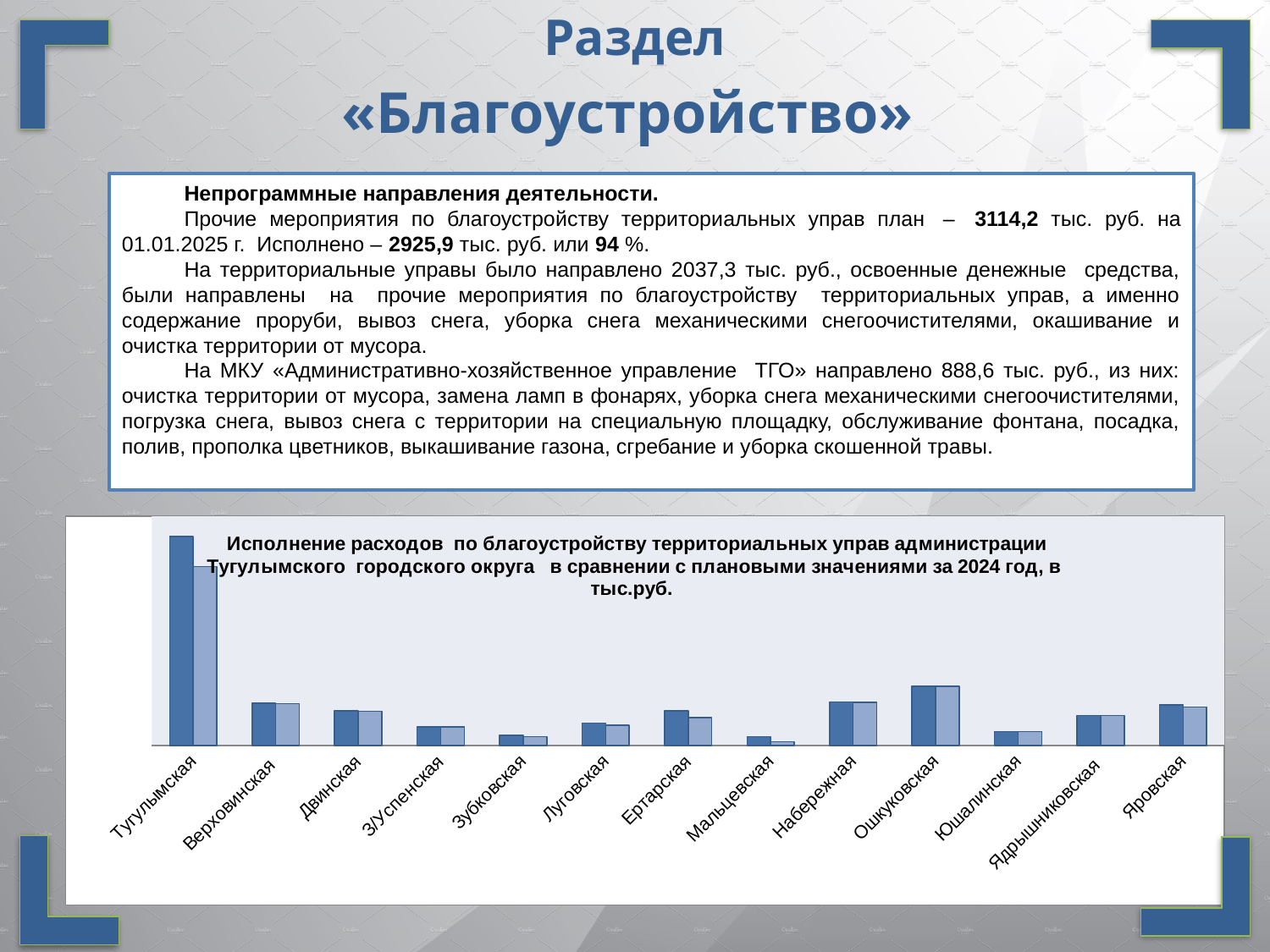
How many bars are plotted for each territorial administration in the chart? 2 In what units are the values in the chart expressed, according to its title? тыс.руб. Which has the larger value in the chart: Ертарская or Зубковская? Ертарская What kind of chart is shown on the slide? bar chart Which has the larger value in the chart: Тугулымская or Верховинская? Тугулымская Which has the larger value in the chart: Набережная or Юшалинская? Набережная Which territorial administration has the highest bars in the chart? Тугулымская How many territorial administrations (categories) are shown on the x axis of the chart? 13 Which category is the first one on the x axis of the chart? Тугулымская